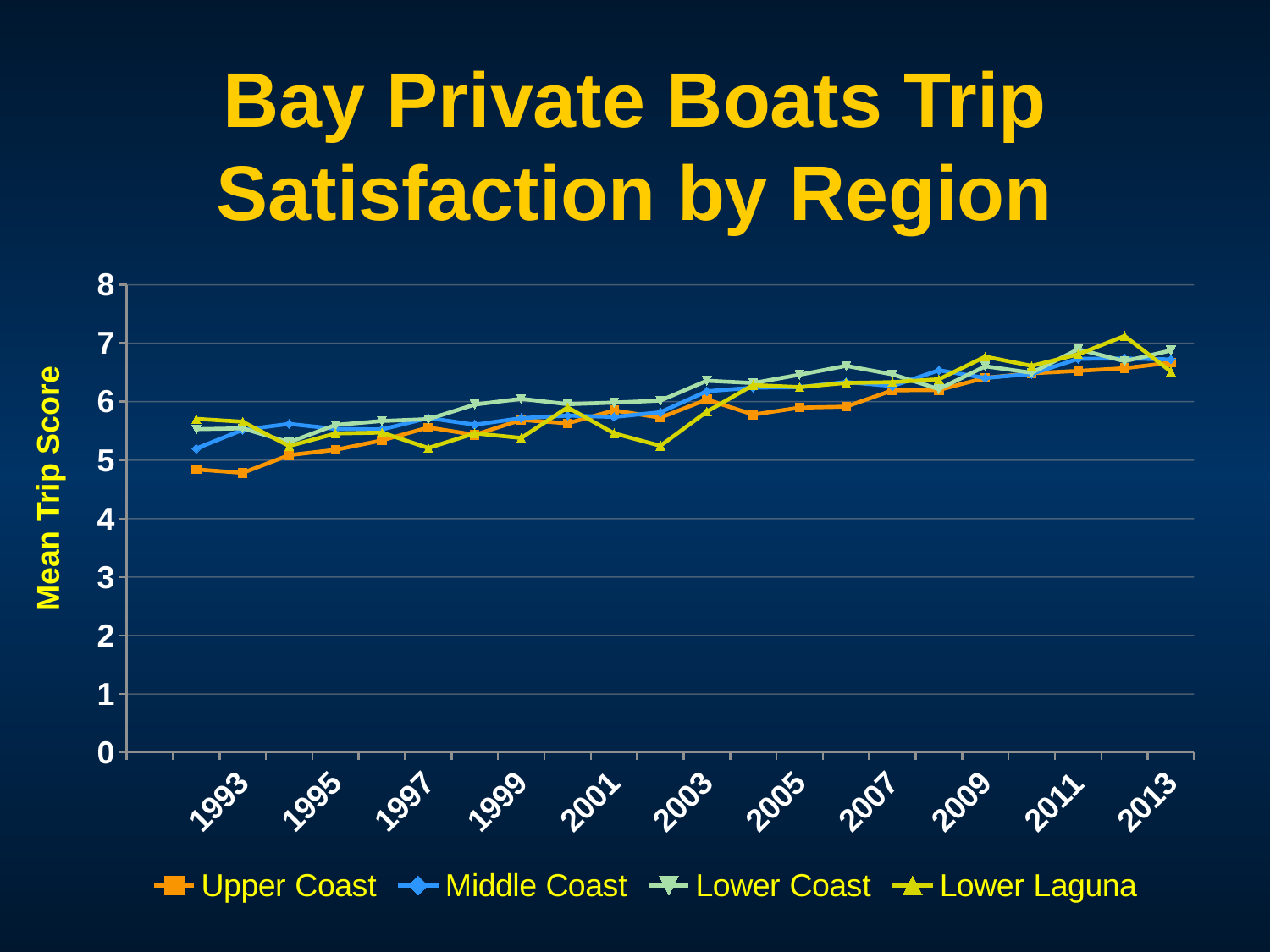
Is the value for Middle Coast in 2013 greater or less than 6? greater Is the value for Lower Coast in 2011 greater or less than 6? greater Which series has the lowest value in 1993? Upper Coast Is the value for Lower Laguna in 2002 greater or less than 6? less In 1993, which is larger: the value for Upper Coast or the value for Lower Laguna? Lower Laguna What is the title of the chart? Bay Private Boats Trip Satisfaction by Region What kind of chart is shown on the slide? line chart What is the label on the vertical axis? Mean Trip Score Do the Upper Coast values generally rise or fall from 1993 to 2013? rise How many series does the legend list? 4 How many year labels are shown on the x axis? 11